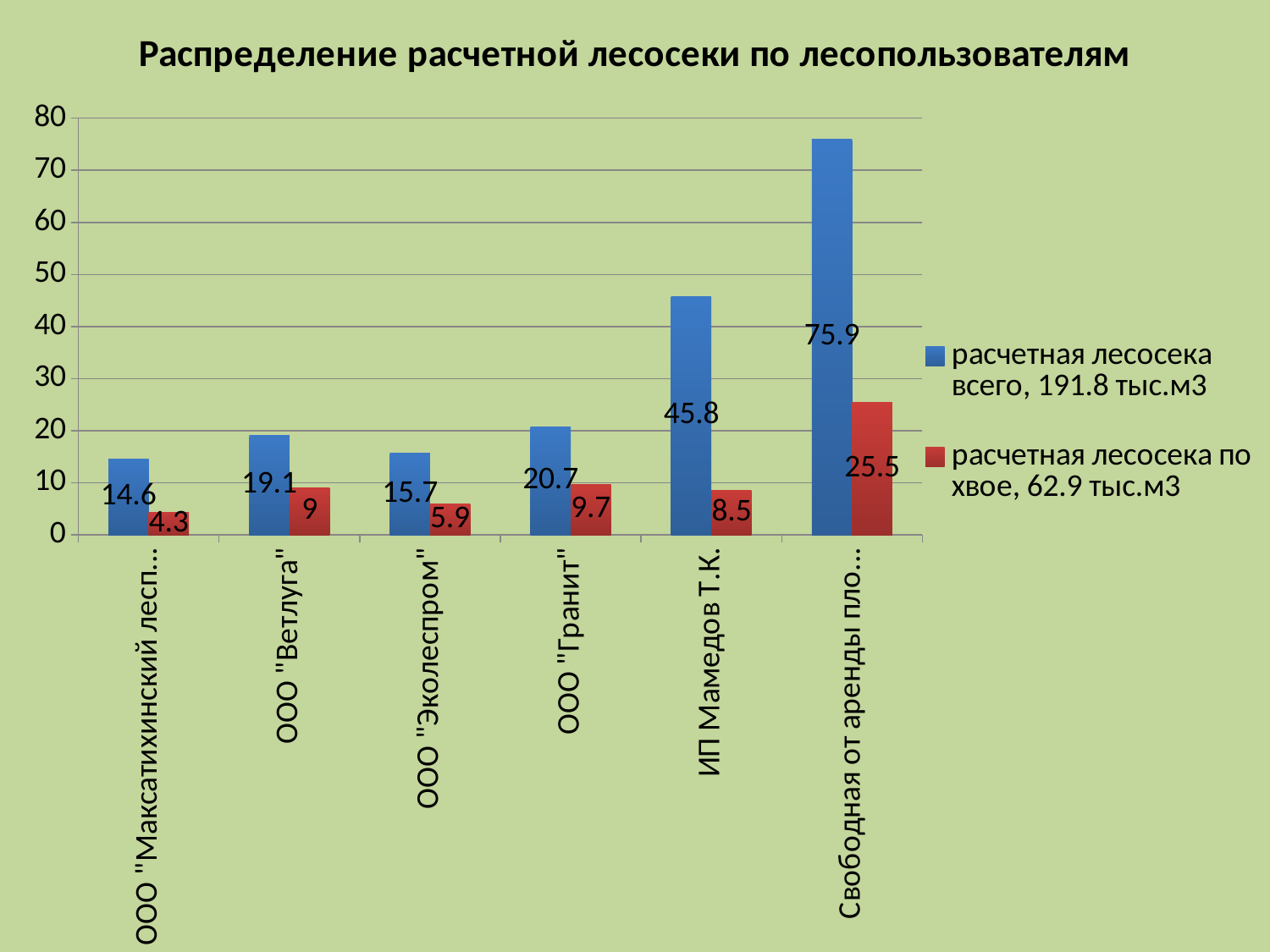
What is the value of 'расчетная лесосека по хвое' for ООО "Ветлуга"? 9 Which has a larger 'расчетная лесосека по хвое' value: ООО "Гранит" or ООО "Эколеспром"? ООО "Гранит" What is the value of 'расчетная лесосека всего' for ООО "Эколеспром"? 15.7 What is the difference in 'расчетная лесосека всего' between ООО "Гранит" and ООО "Ветлуга"? 1.6 How many series does the legend list? 2 What is the value of 'расчетная лесосека по хвое' for ООО "Эколеспром"? 5.9 What is the value of 'расчетная лесосека всего' for ООО "Гранит"? 20.7 What is the title of the chart? Распределение расчетной лесосеки по лесопользователям How many categories (forest users) are shown on the x axis? 6 What type of chart is shown on the slide? bar chart What is the value of 'расчетная лесосека всего' for ИП Мамедов Т.К.? 45.8 What is the difference between 'расчетная лесосека всего' and 'расчетная лесосека по хвое' for ИП Мамедов Т.К.? 37.3